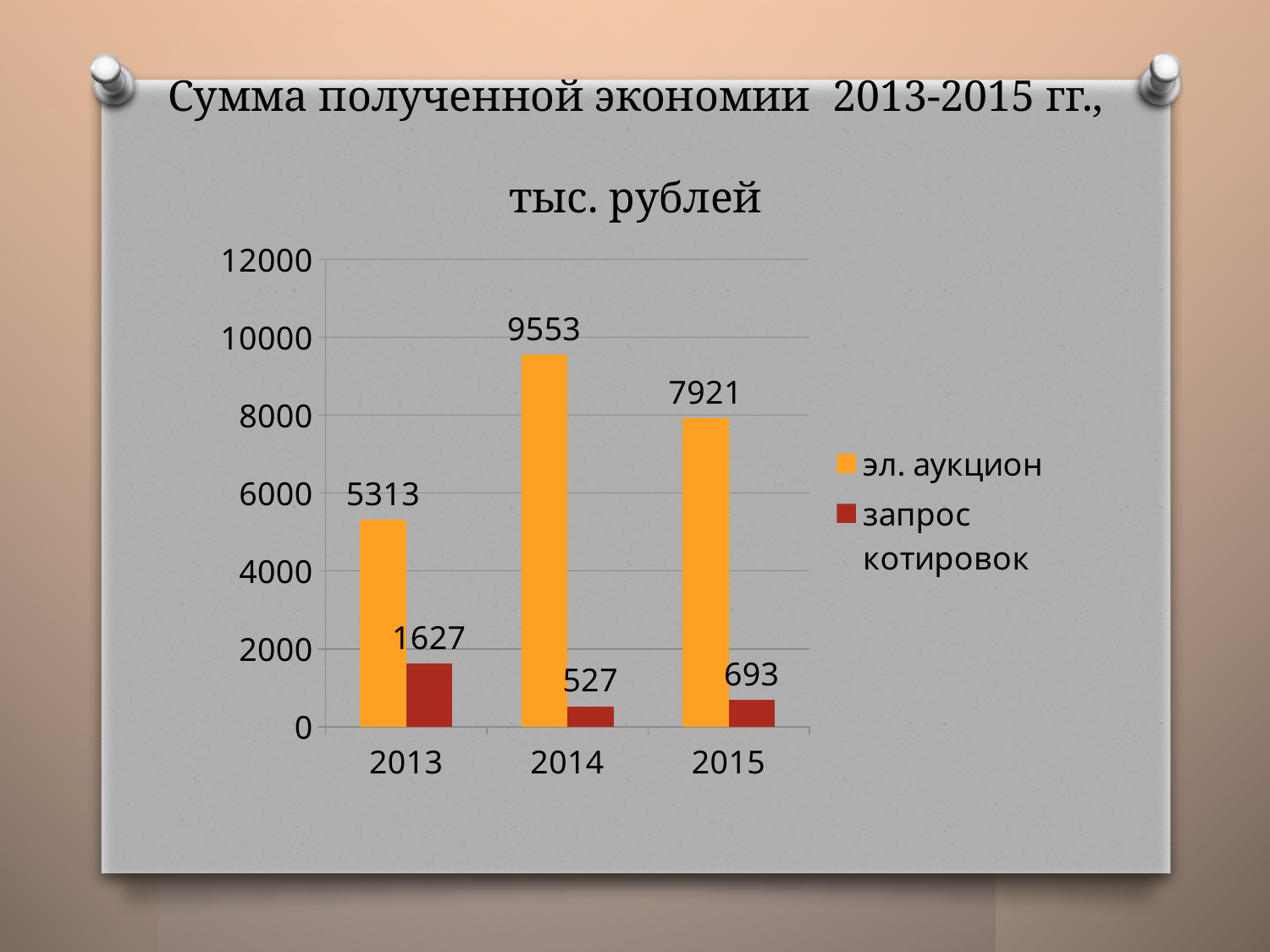
Which is larger: запрос котировок in 2015 or запрос котировок in 2014? запрос котировок in 2015 What colour are the bars for эл. аукцион? orange What is the difference between the эл. аукцион values for 2014 and 2015? 1632 In which year is the value for запрос котировок lowest? 2014 What is the value for запрос котировок in 2013? 1627 What kind of chart is shown on the slide? bar chart How many years are shown on the x axis? 3 What is the value for эл. аукцион in 2015? 7921 In which year is the value for эл. аукцион highest? 2014 What is the value for эл. аукцион in 2014? 9553 How many series does the legend list? 2 Is the value for эл. аукцион in 2013 greater or less than 6000? less